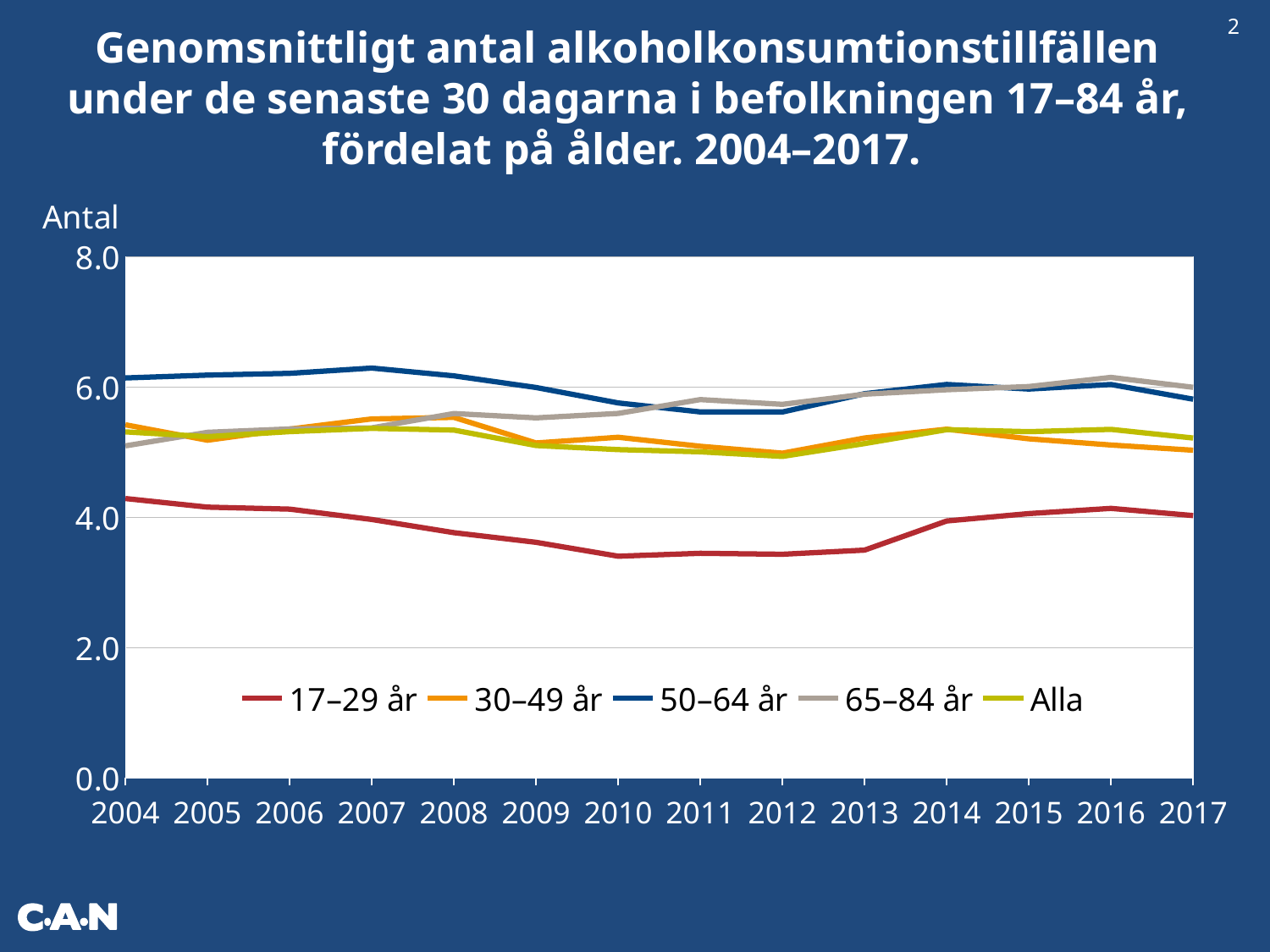
What label is shown on the y axis? Antal Is the value for 50–64 år in 2012 greater or less than 6.0? less What kind of chart is shown on the slide? Line chart How many years are shown along the x axis? 14 Which series has the lowest value in 2010? 17–29 år How many series does the legend list? 5 In 2010, which is larger: the value for 50–64 år or the value for 17–29 år? 50–64 år Which series has the highest value in 2007? 50–64 år Is the value for 17–29 år in 2010 greater or less than 4.0? less Does the value for 17–29 år rise or fall from 2004 to 2010? fall Is the value for 50–64 år in 2007 greater or less than 6.0? greater